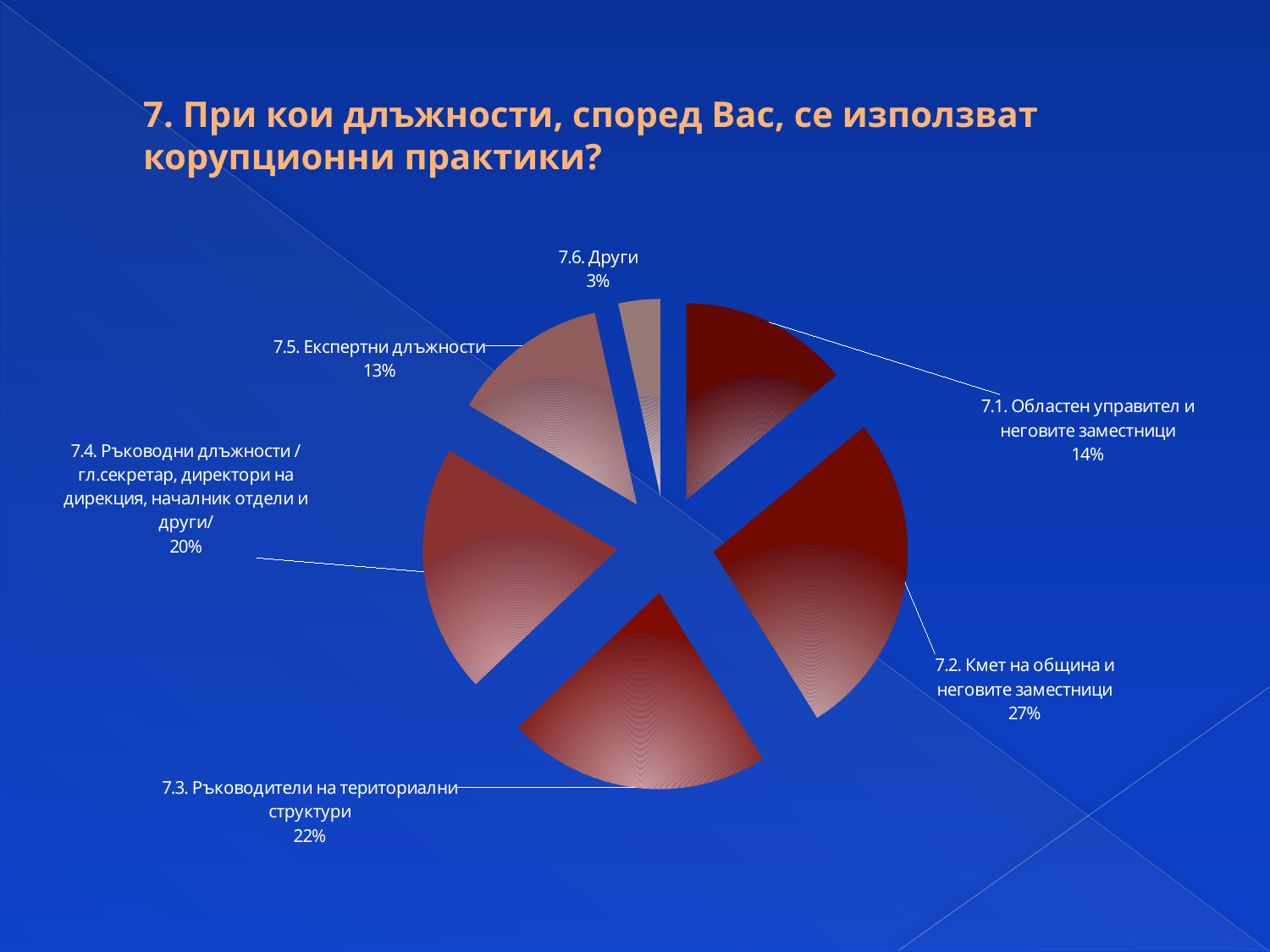
What kind of chart is shown on the slide? Pie chart What percentage is shown for "7.1. Областен управител и неговите заместници"? 14% Which category has the largest share of the pie? 7.2. Кмет на община и неговите заместници What is the difference in percentage points between "7.2. Кмет на община и неговите заместници" and "7.3. Ръководители на териториални структури"? 5 percentage points Which has a larger share: "7.4. Ръководни длъжности" or "7.1. Областен управител и неговите заместници"? 7.4. Ръководни длъжности What is the combined share of "7.5. Експертни длъжности" and "7.6. Други"? 16% What percentage is shown for "7.2. Кмет на община и неговите заместници"? 27% Which category has the smallest share of the pie? 7.6. Други What is the title of the slide containing the chart? 7. При кои длъжности, според Вас, се използват корупционни практики? What percentage is shown for "7.6. Други"? 3% How many slices does the pie chart have? 6 What percentage is shown for "7.5. Експертни длъжности"? 13%